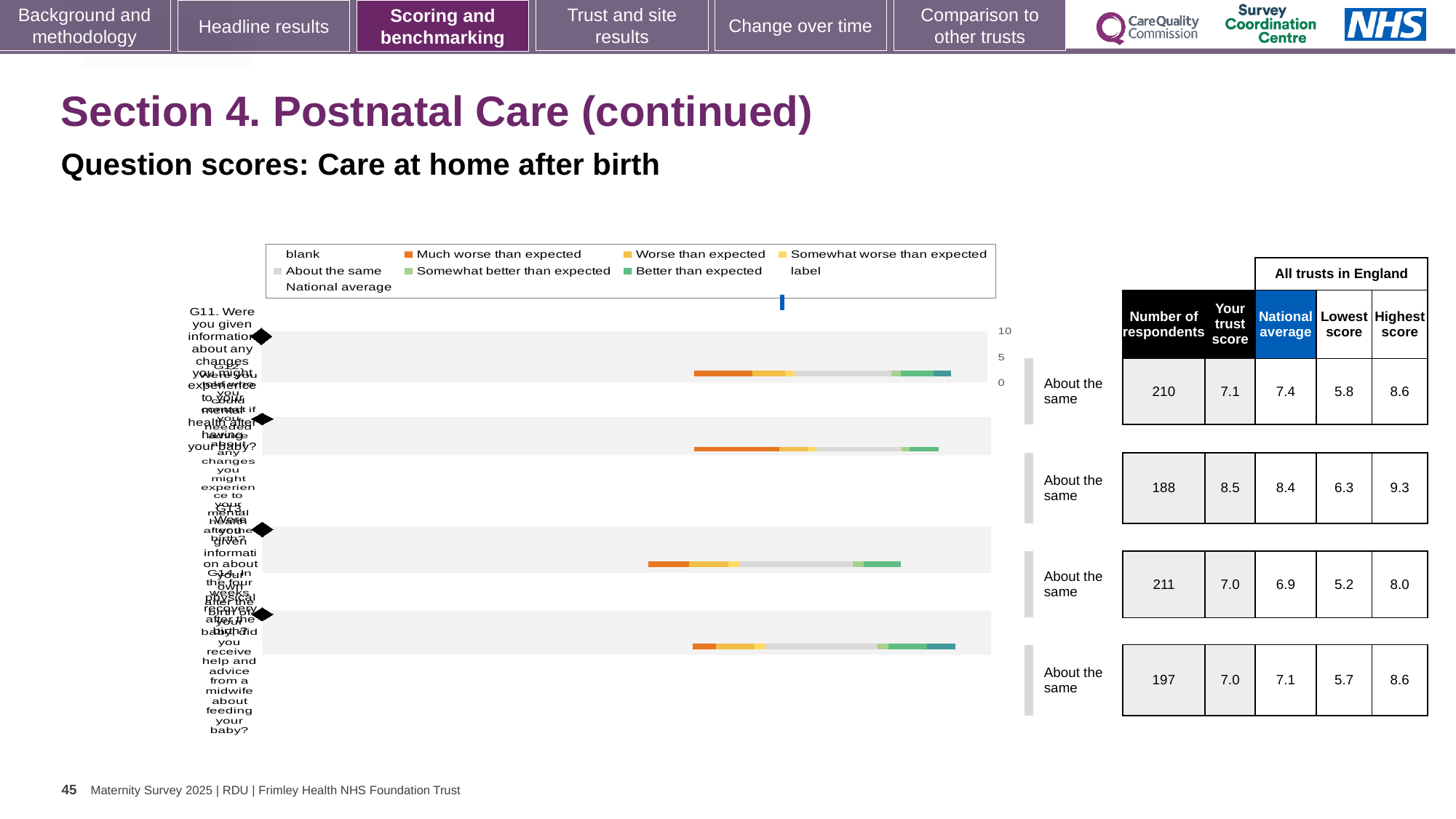
In the chart legend, what colour represents 'Much worse than expected'? orange What kind of chart is shown on the slide? bar chart In the table beside the chart, what is the national average for the fourth row? 7.1 In the table beside the chart, what is the difference between the highest score and the lowest score in the second row? 3.0 How many question bars are plotted in the chart? 4 How many of the four questions are rated 'About the same' in the benchmark column next to the chart? 4 In the table beside the chart, what is the number of respondents for the first row? 210 In the table beside the chart, which row has the lowest 'Lowest score' value? the third row (5.2) In the table beside the chart, what is 'Your trust score' for the second row? 8.5 In the chart legend, what does the blue vertical marker represent? National average In the table beside the chart, which row has the highest 'Highest score' value? the second row (9.3) In the table beside the chart, for the first row, which is larger: 'Your trust score' or the national average? National average